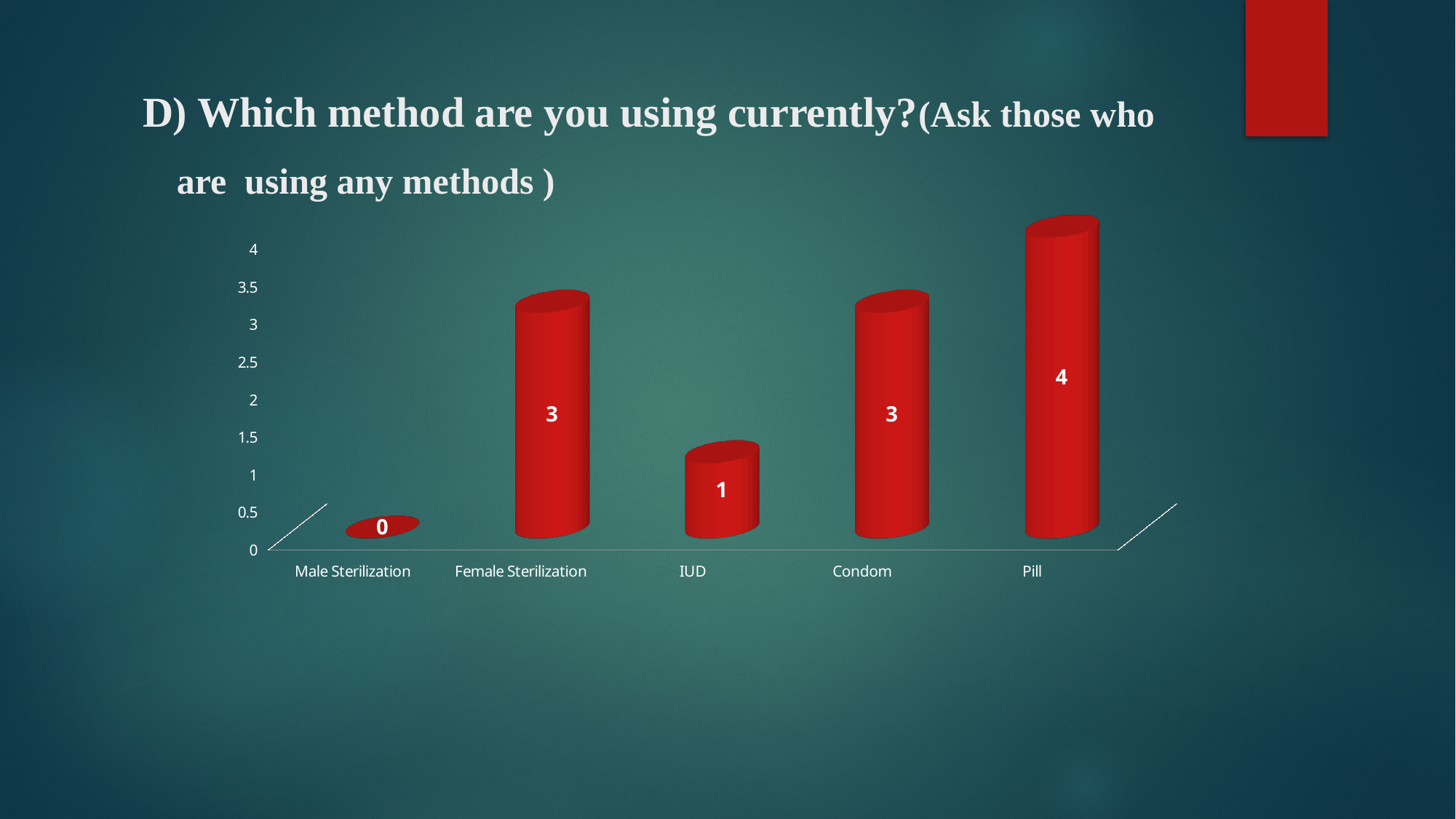
What is the value for Pill? 4 What is the value for Condom? 3 What colour are the bars in the chart? red Which is larger, the value for Female Sterilization or the value for IUD? Female Sterilization What kind of chart is shown on the slide? bar chart What is the value for IUD? 1 Is the value for Condom greater or less than 2? greater Which method has the lowest value? Male Sterilization What is the value for Male Sterilization? 0 How many methods are shown on the x axis? 5 What is the difference between the values for Pill and IUD? 3 Which method has the highest value? Pill